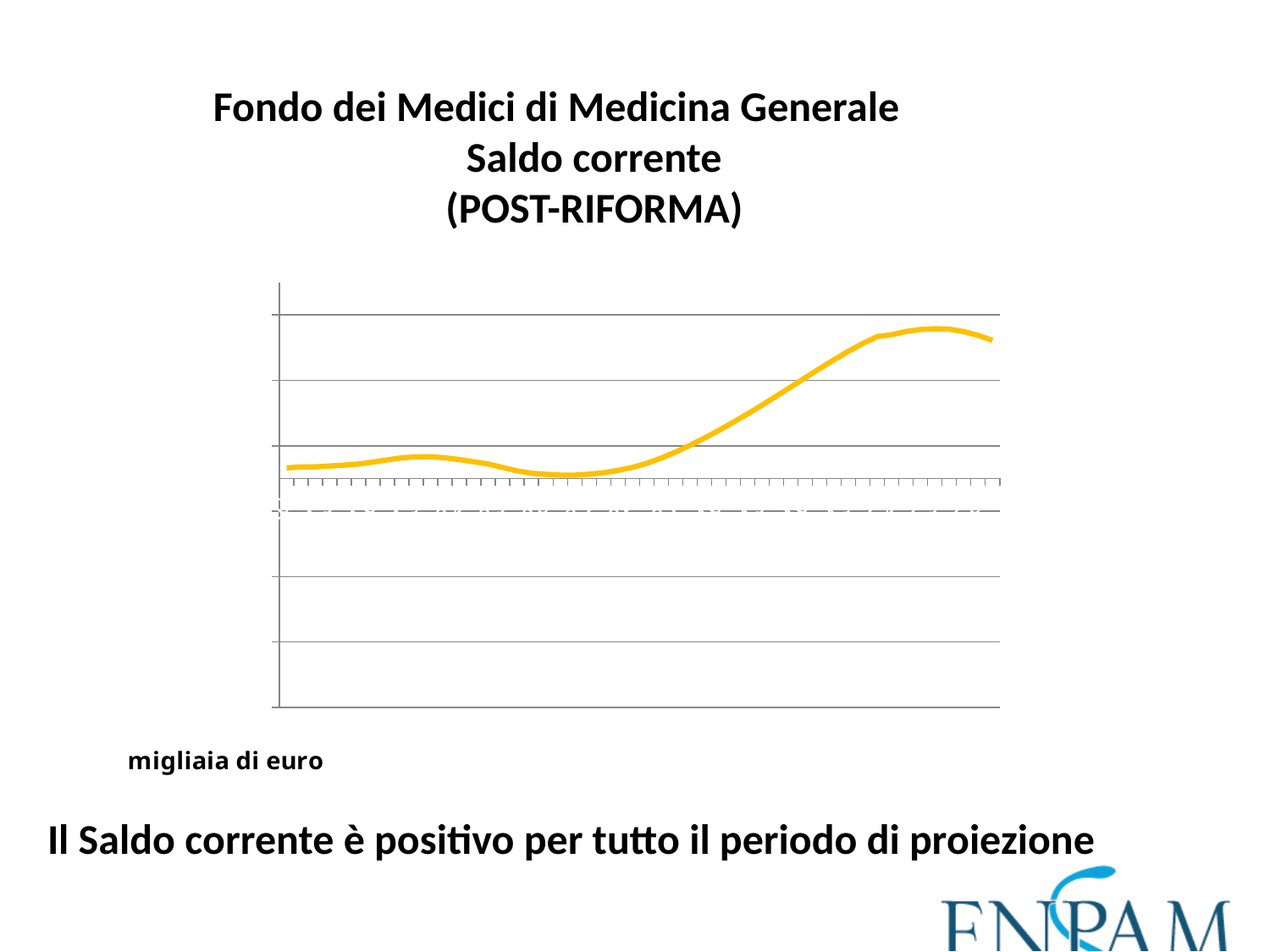
What is the title of the chart on the slide? Fondo dei Medici di Medicina Generale Saldo corrente (POST-RIFORMA) Does the line in the chart generally rise or fall from left to right? rise What kind of chart is shown on the slide? line chart What colour is the line plotted in the chart? yellow How many lines (series) are plotted in the chart? 1